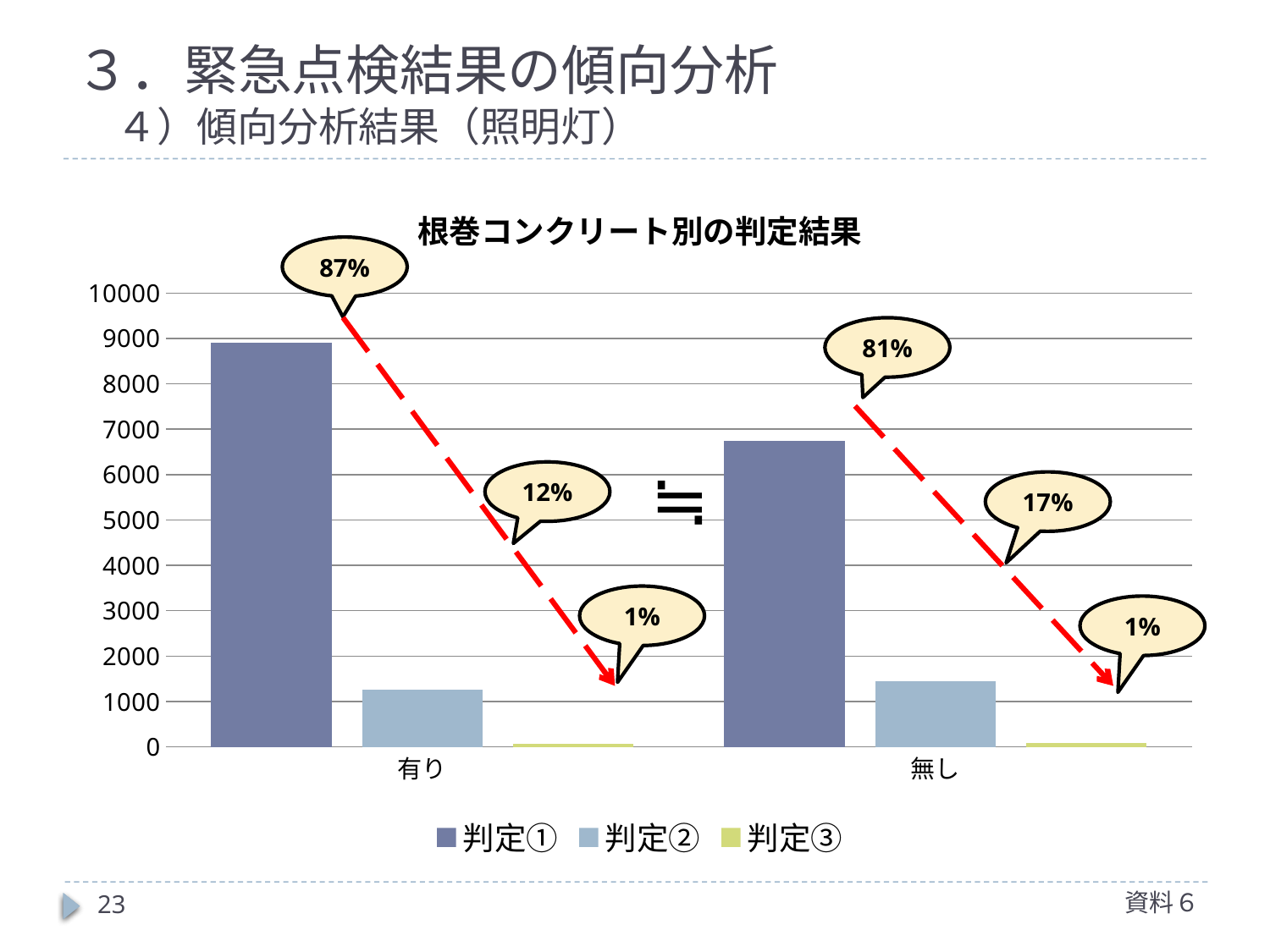
Is the value of 判定③ for 有り greater or less than 1000? less What is the title of the chart? 根巻コンクリート別の判定結果 Which series has the highest bar in the chart? 判定① for 有り How many series does the legend list? 3 Is the value of 判定① for 有り greater or less than 8000? greater What percentage is shown in the callout above the 判定① bar for 無し? 81% Is the value of 判定② for 無し greater or less than 1000? greater Which category has the larger value for 判定①, 有り or 無し? 有り Which category has the larger value for 判定②, 有り or 無し? 無し What type of chart is shown on the slide? bar chart How many categories are shown on the x axis? 2